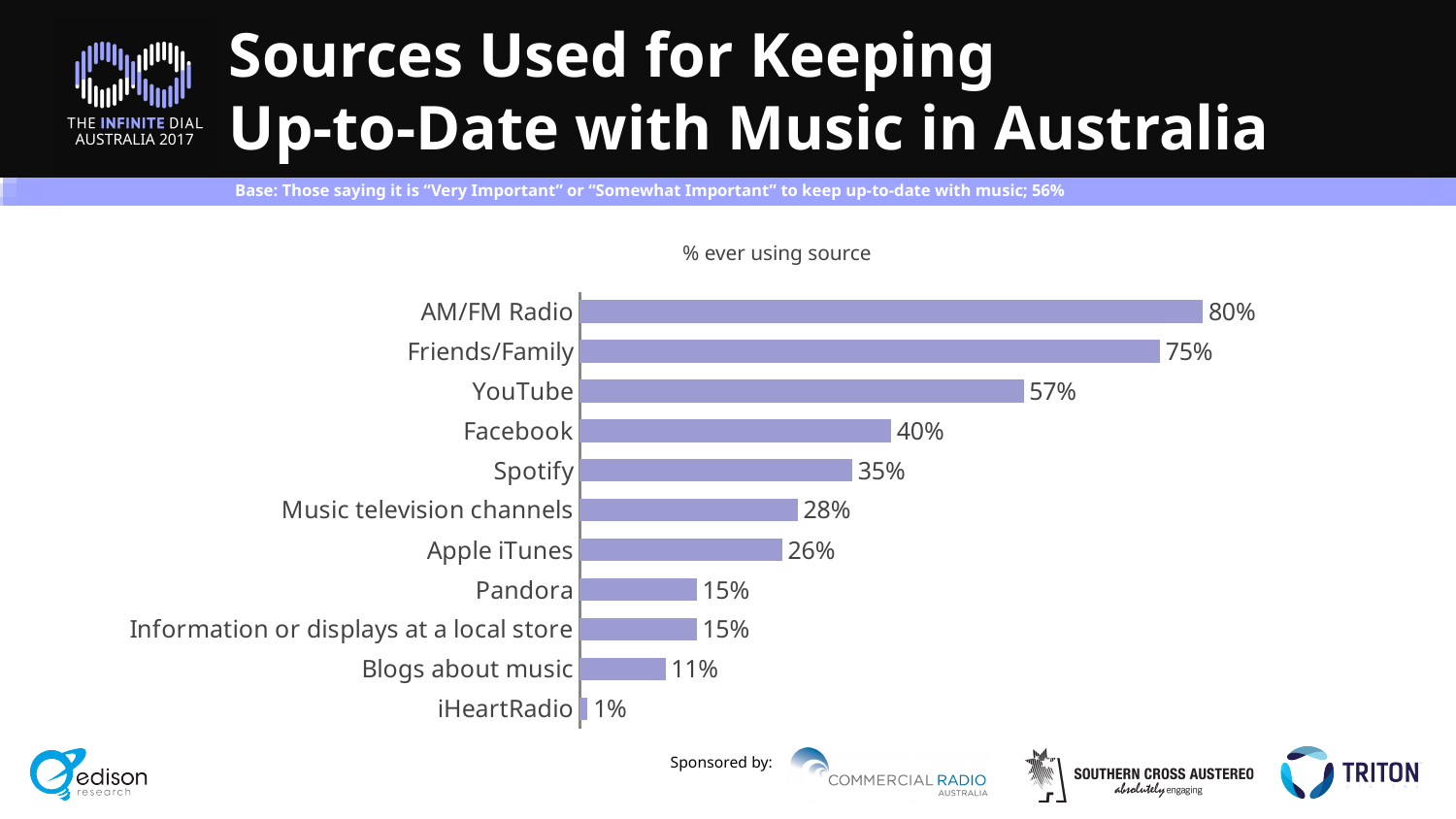
What is the label shown above the chart describing the measure? % ever using source Which is larger, Facebook or Spotify? Facebook What is the difference in percentage points between YouTube and Facebook? 17 What percentage is shown for Blogs about music? 11% Which source has the highest percentage of people ever using it? AM/FM Radio What is the value shown for Spotify? 35% How many sources are listed in the chart? 11 Which has a higher value, Music television channels or Apple iTunes? Music television channels What is the difference between AM/FM Radio and Friends/Family? 5 Which source has the lowest percentage? iHeartRadio What percentage of respondents ever use AM/FM Radio to keep up-to-date with music? 80% What type of chart is shown on the slide? Bar chart